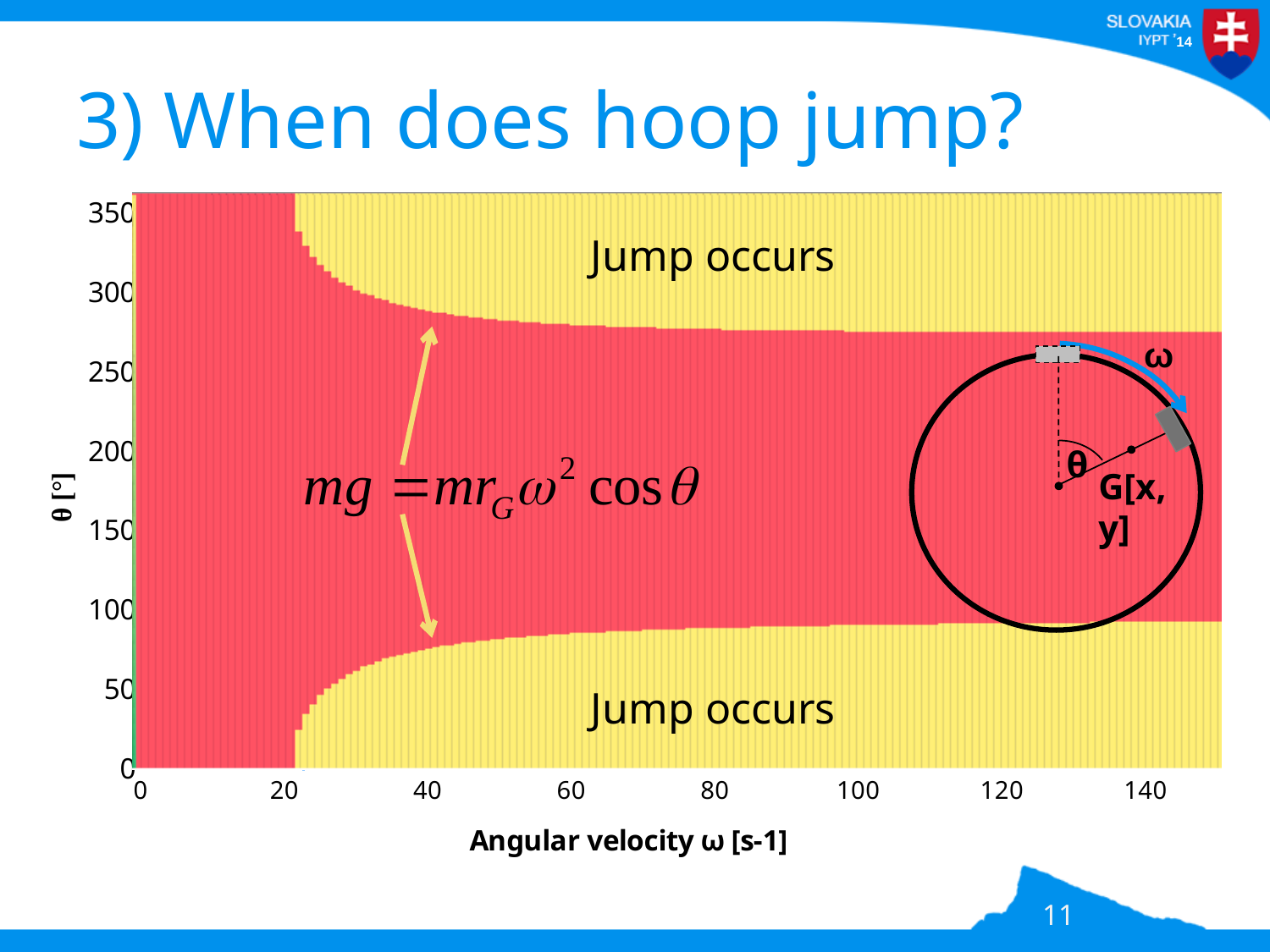
At an angular velocity of 40, is the lower boundary of the red (no-jump) region greater or less than 50? greater What text labels the yellow regions of the chart? Jump occurs How many separate 'Jump occurs' regions are shown on the chart? 2 How many tick labels are shown on the x axis of the chart? 8 What is the label on the x axis of the chart? Angular velocity ω [s-1] As angular velocity increases from 20 to 140, does the upper boundary of the red (no-jump) region rise or fall? fall What is the highest value labelled on the θ axis of the chart? 350 As angular velocity increases from 20 to 140, does the lower boundary of the red (no-jump) region rise or fall? rise At an angular velocity of 100, is the upper boundary of the red (no-jump) region greater or less than 300? less What is the highest value labelled on the x axis of the chart? 140 Is the angular velocity at which the yellow 'Jump occurs' regions first appear greater or less than 40? less